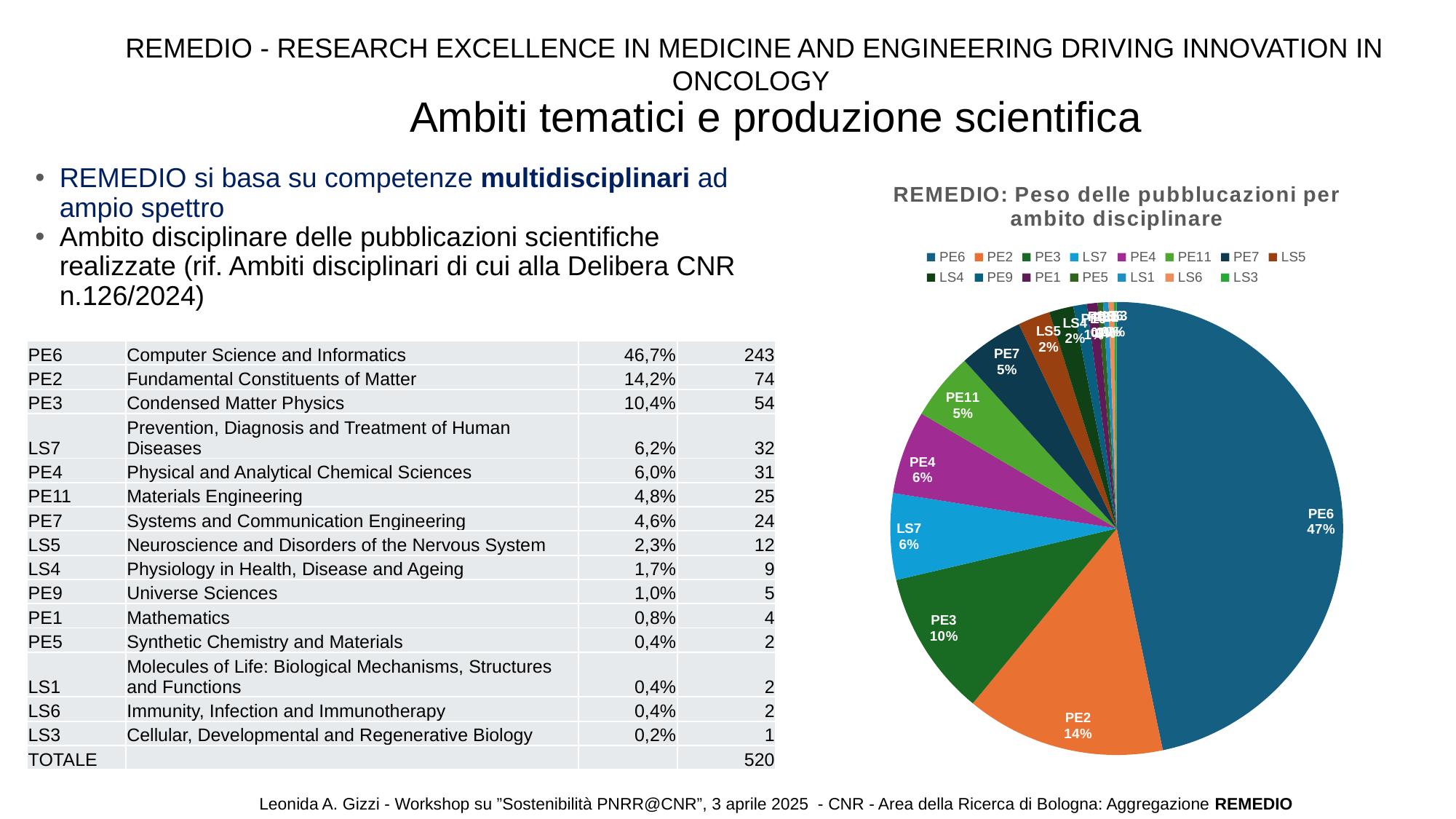
What share of the pie does LS5 hold? 2% What share of the pie does LS7 hold? 6% How many categories does the legend of the pie chart list? 15 What share of the pie does PE2 hold? 14% What is the title of the chart? REMEDIO: Peso delle pubblucazioni per ambito disciplinare Which is larger, the slice for PE2 or the slice for PE3? PE2 What kind of chart is shown on the slide? pie chart What is the difference in percentage points between the PE6 slice and the PE2 slice? 33 Which category has the largest slice of the pie? PE6